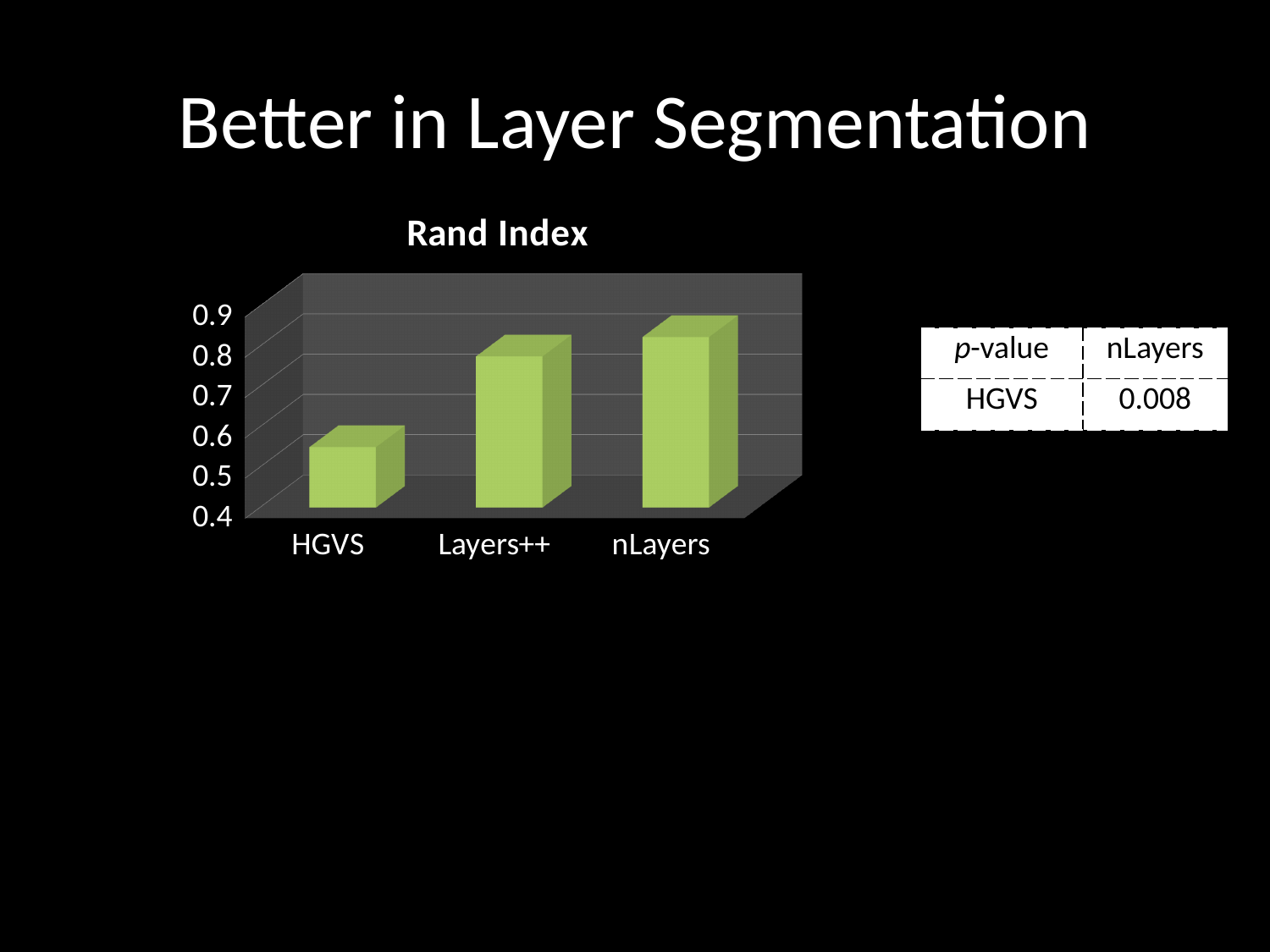
What is the lowest value shown on the vertical axis of the chart? 0.4 What is the title of the chart? Rand Index How many categories are plotted in the Rand Index chart? 3 Is the Rand Index value for nLayers greater or less than 0.7? greater Do the Rand Index values rise or fall from HGVS to nLayers along the x axis? rise Is the Rand Index value for HGVS greater or less than 0.7? less What kind of chart is shown on the slide? bar chart Is the Rand Index value for HGVS greater or less than 0.5? greater Which has a higher Rand Index, HGVS or nLayers? nLayers Which has a higher Rand Index, HGVS or Layers++? Layers++ Which category has the lowest Rand Index? HGVS